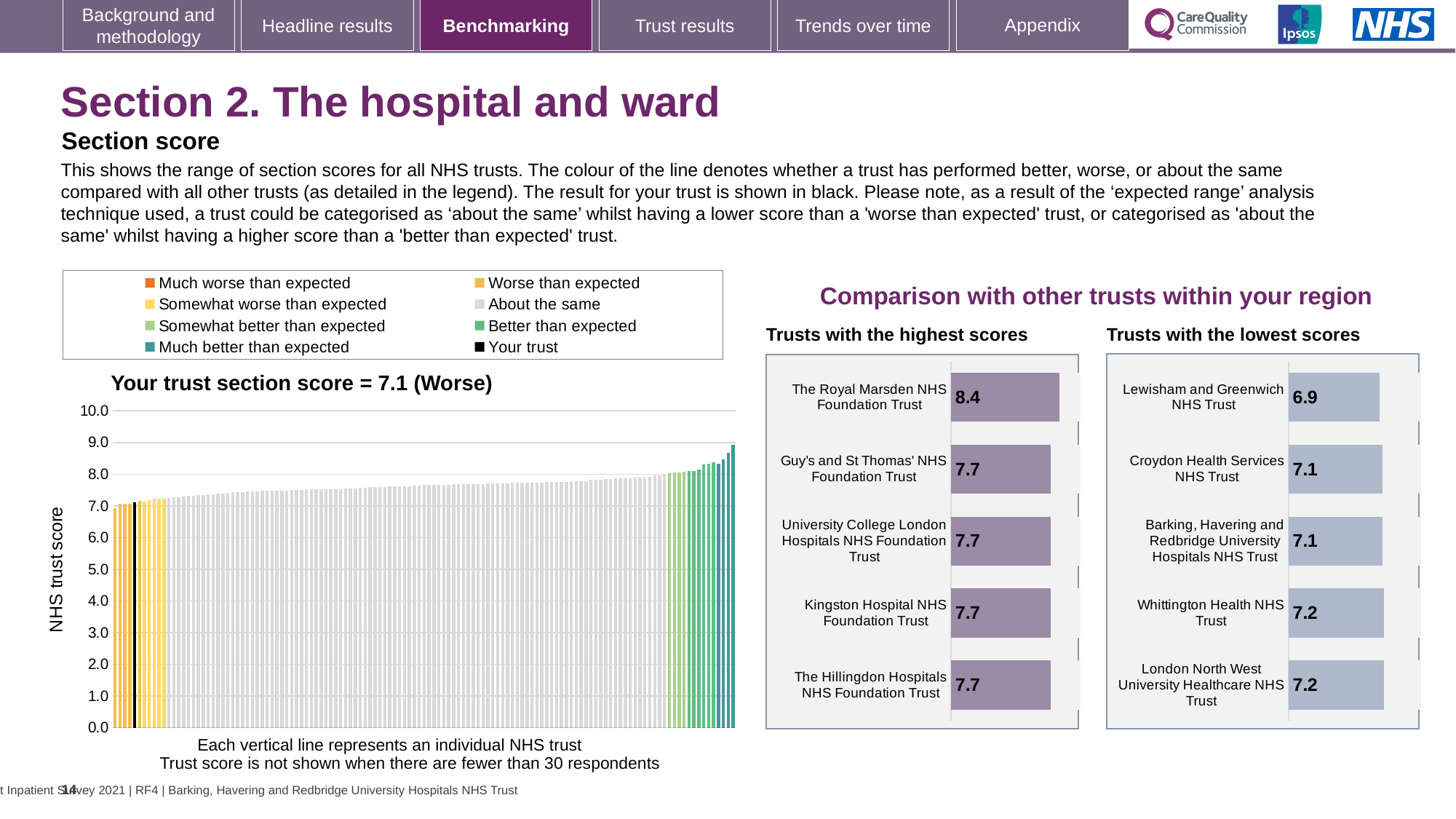
How many trusts are shown in the 'Trusts with the lowest scores' chart? 5 What is the y-axis label of the 'Your trust section score' chart? NHS trust score In the 'Trusts with the highest scores' chart, what is the score for The Royal Marsden NHS Foundation Trust? 8.4 What kind of chart is the 'Your trust section score = 7.1 (Worse)' chart? bar chart In the 'Trusts with the lowest scores' chart, what is the score for Lewisham and Greenwich NHS Trust? 6.9 In the 'Trusts with the lowest scores' chart, which trust has the lowest score? Lewisham and Greenwich NHS Trust In the 'Your trust section score' chart, is the value of the rightmost bar greater or less than 8.0? greater How many entries does the legend above the 'Your trust section score' chart list? 8 In the 'Trusts with the highest scores' chart, which trust has the highest score? The Royal Marsden NHS Foundation Trust In the 'Trusts with the highest scores' chart, what is the difference between The Royal Marsden NHS Foundation Trust and Kingston Hospital NHS Foundation Trust? 0.7 In the 'Your trust section score' chart, what is the section score for your trust? 7.1 In the 'Your trust section score' chart, do the bars rise or fall from left to right? rise